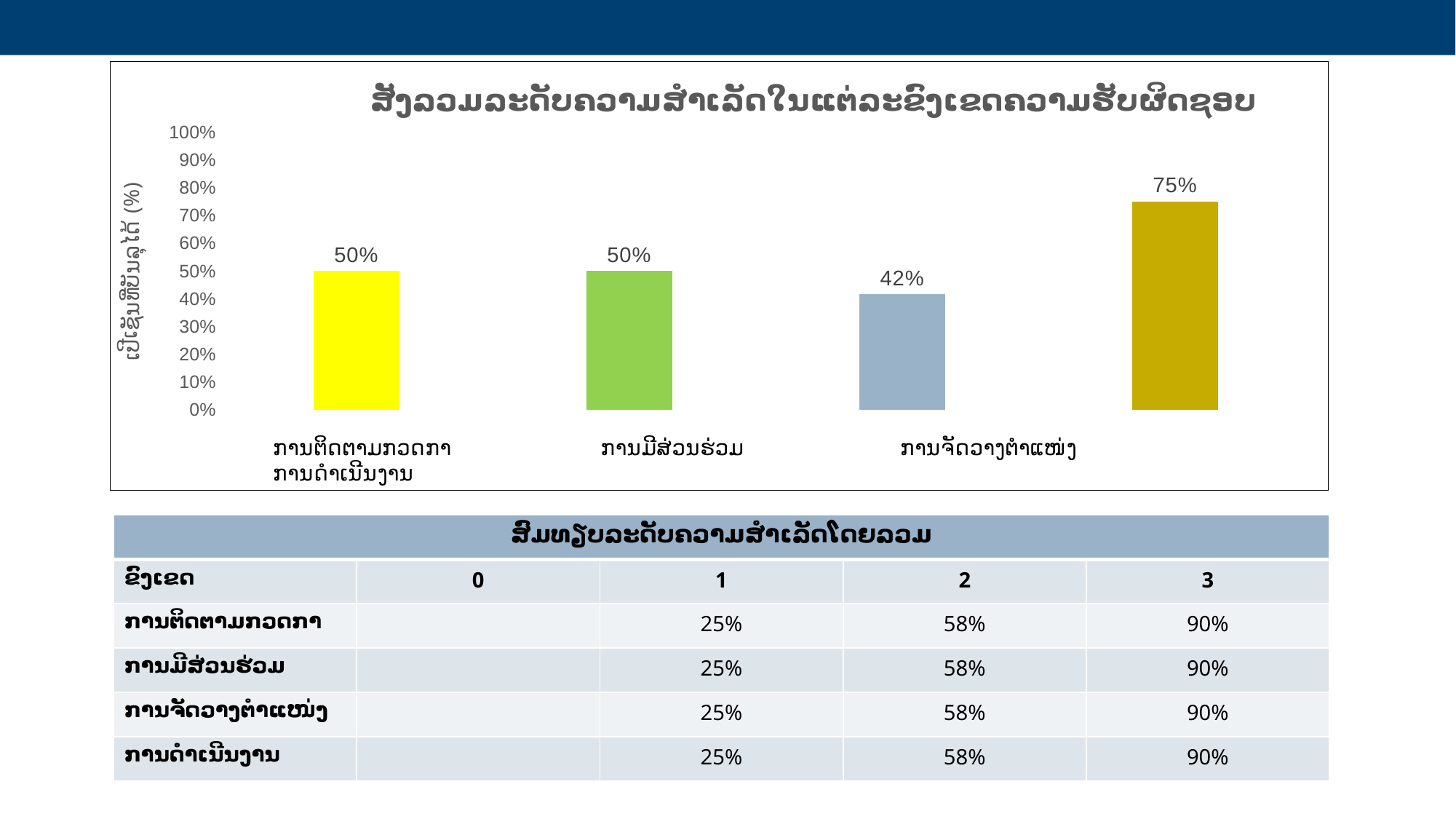
What is the value shown for ການຈັດວາງຕຳແໜ່ງ in the bar chart? 42% What colour is the bar for ການມີສ່ວນຮ່ວມ? Green What value is labelled on the rightmost (gold) bar of the chart? 75% Which category has the lowest value in the bar chart? ການຈັດວາງຕຳແໜ່ງ What type of chart is shown on the slide? Bar chart What is the difference between the rightmost bar (75%) and ການຈັດວາງຕຳແໜ່ງ (42%)? 33 percentage points What is the value shown for ການມີສ່ວນຮ່ວມ in the bar chart? 50% Which is larger in the bar chart: ການຕິດຕາມກວດກາ or ການຈັດວາງຕຳແໜ່ງ? ການຕິດຕາມກວດກາ Which bar in the chart has the highest value? The rightmost (gold) bar, 75% How many bars are plotted in the chart? 4 Is the value of the rightmost bar greater or less than 70%? greater What is the value shown for ການຕິດຕາມກວດກາ in the bar chart? 50%